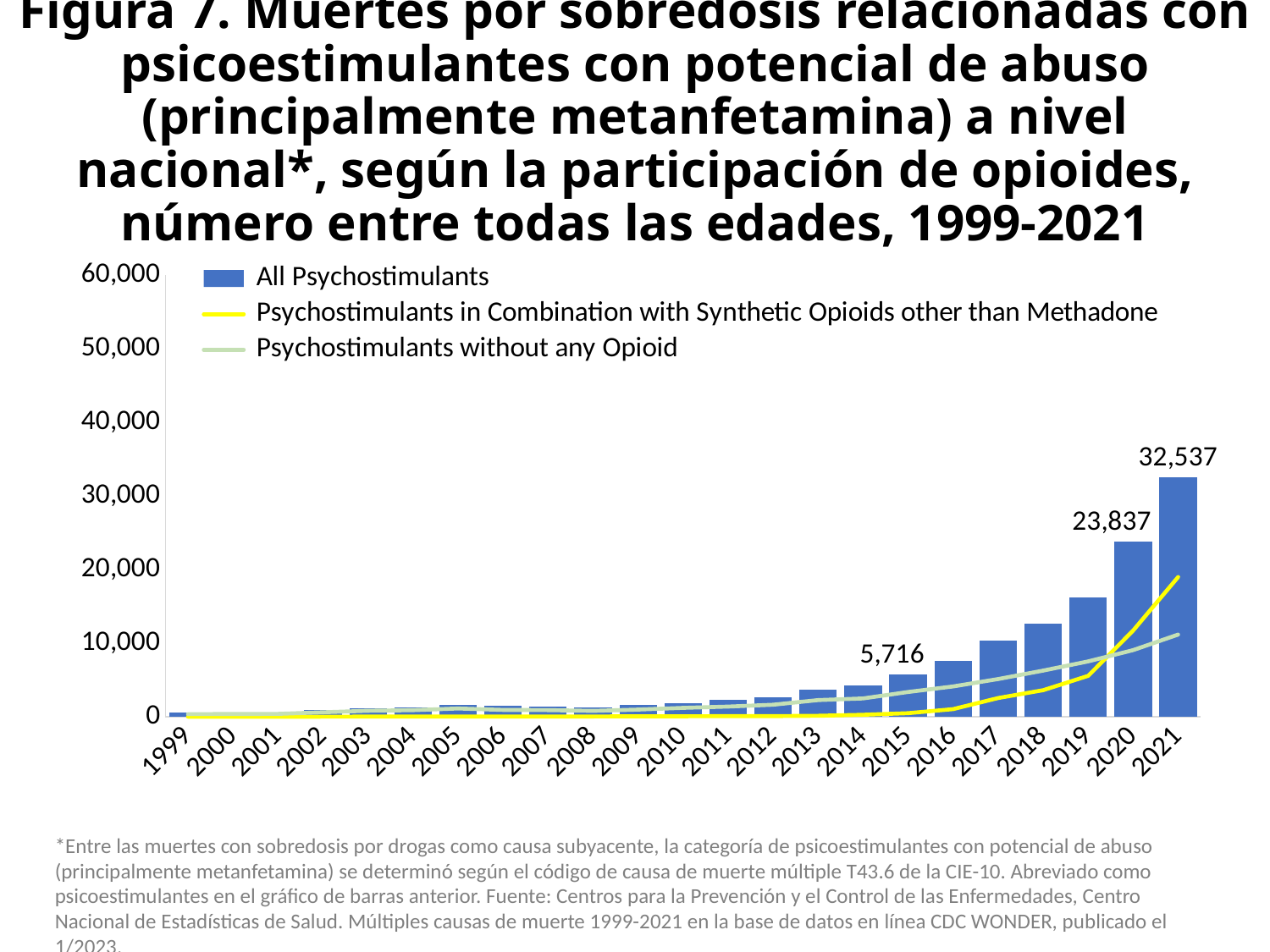
Is the All Psychostimulants value for 2018 greater or less than 10,000? greater What is the difference between the All Psychostimulants values for 2021 and 2020? 8,700 What is the value for All Psychostimulants in 2020? 23,837 What is the value for All Psychostimulants in 2015? 5,716 What is the difference between the All Psychostimulants values for 2020 and 2015? 18,121 Which is larger, the All Psychostimulants value for 2019 or for 2016? 2019 What is the value for All Psychostimulants in 2021? 32,537 How many series does the legend list? 3 How many years are shown on the x axis? 23 Is the All Psychostimulants value for 2013 greater or less than 10,000? less Which year has the highest value for All Psychostimulants? 2021 Do the All Psychostimulants values generally rise or fall from 1999 to 2021? rise